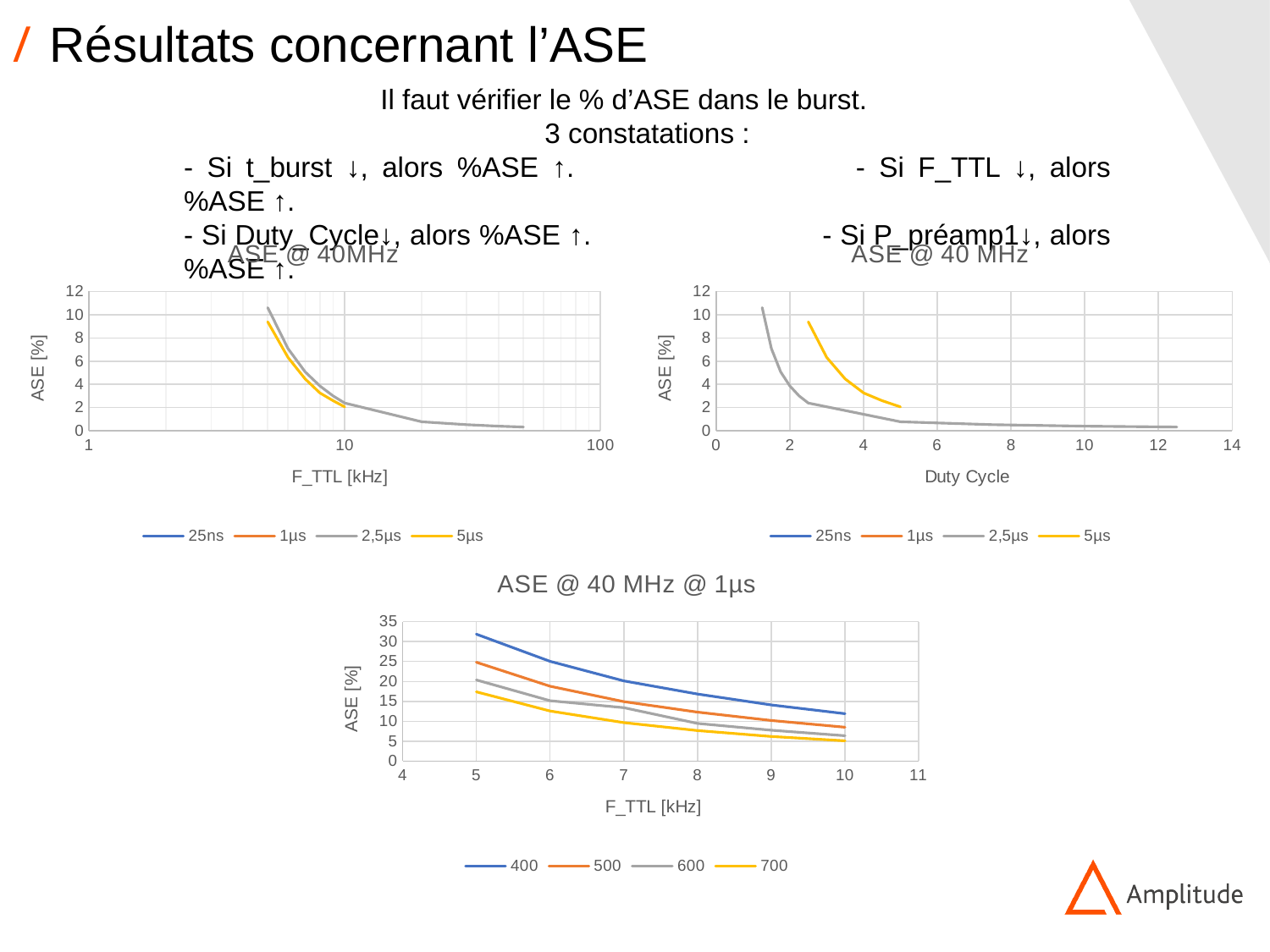
In the bottom chart 'ASE @ 40 MHz @ 1µs', what are the legend entries? 400, 500, 600, 700 In the top-right chart 'ASE @ 40 MHz', do the values rise or fall as Duty Cycle increases? fall How many series does the legend of the bottom chart 'ASE @ 40 MHz @ 1µs' list? 4 In the bottom chart 'ASE @ 40 MHz @ 1µs', which series has the larger value at F_TTL = 5 kHz, 400 or 700? 400 In the bottom chart 'ASE @ 40 MHz @ 1µs', which series has the highest values across the plotted range? 400 In the bottom chart 'ASE @ 40 MHz @ 1µs', do the values rise or fall as F_TTL increases? fall What kind of chart is the bottom chart titled 'ASE @ 40 MHz @ 1µs'? line chart What is the x-axis label of the top-right chart? Duty Cycle In the bottom chart 'ASE @ 40 MHz @ 1µs', is the value of the 700 series at F_TTL = 5 kHz greater or less than 20? less In the bottom chart 'ASE @ 40 MHz @ 1µs', is the value of the 400 series at F_TTL = 5 kHz greater or less than 30? greater How many series does the legend of the top-left chart 'ASE @ 40MHz' list? 4 In the top-left chart 'ASE @ 40MHz', is the highest plotted value of the grey 2,5µs series greater or less than 10? greater